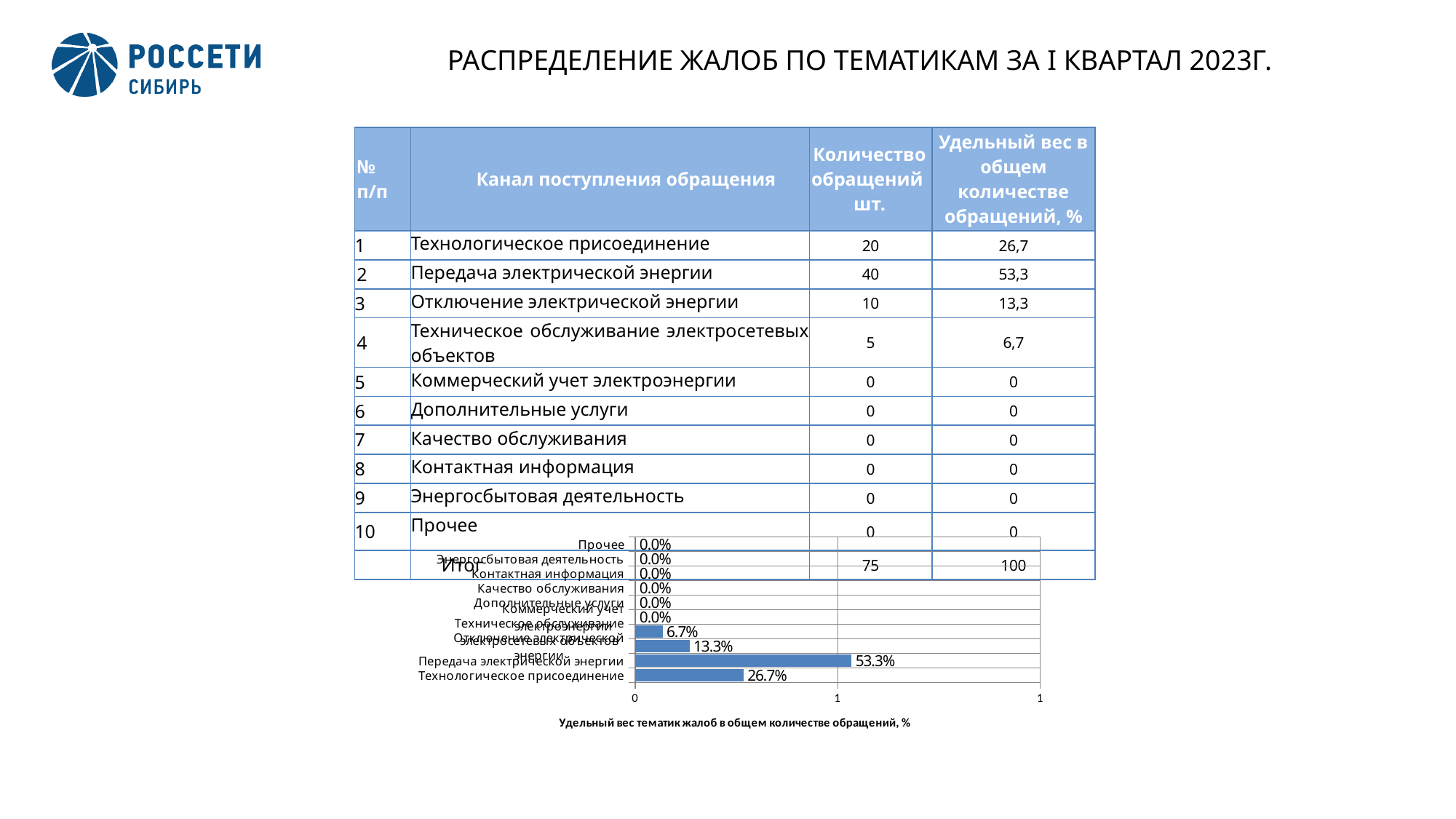
What is the value for Технологическое присоединение in the chart? 26.7% What type of chart is shown on the slide? bar chart What is the title of the chart? Удельный вес тематик жалоб в общем количестве обращений, % What is the value for Качество обслуживания in the chart? 0.0% Which category has the highest value in the chart? Передача электрической энергии What is the value for Передача электрической энергии in the chart? 53.3% How many categories in the chart have a value of 0.0%? 6 Which is larger in the chart: Отключение электрической энергии or Техническое обслуживание электросетевых объектов? Отключение электрической энергии What is the value for Отключение электрической энергии in the chart? 13.3% How many categories are plotted in the chart? 10 What is the value for Техническое обслуживание электросетевых объектов in the chart? 6.7% What is the difference between the values for Передача электрической энергии and Технологическое присоединение? 26.6%